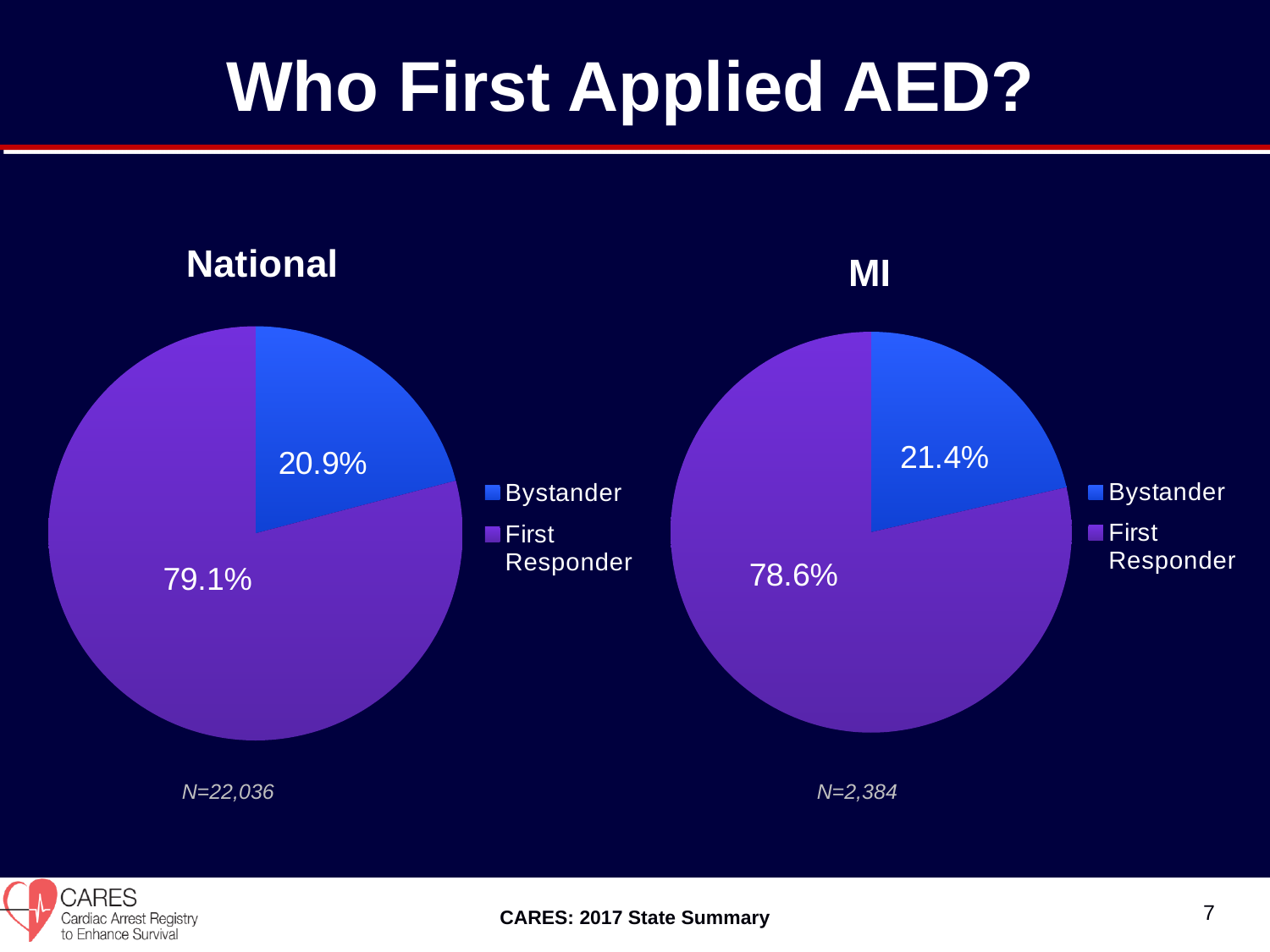
What type of chart is used for the National data? Pie chart In the National chart, what is the difference between the First Responder and Bystander shares? 58.2% In the MI chart, what is the difference between the First Responder and Bystander shares? 57.2% In the National chart, what share of AEDs were first applied by a First Responder? 79.1% What is the N value shown below the National chart? N=22,036 In the National chart, what share of AEDs were first applied by a Bystander? 20.9% How many categories does the legend of the MI chart list? 2 In the MI chart, what share of AEDs were first applied by a First Responder? 78.6% In the MI chart, which category has the smallest slice? Bystander In the MI chart, what share of AEDs were first applied by a Bystander? 21.4% Is the Bystander share larger in the National chart or the MI chart? MI In the National chart, which category has the largest slice? First Responder